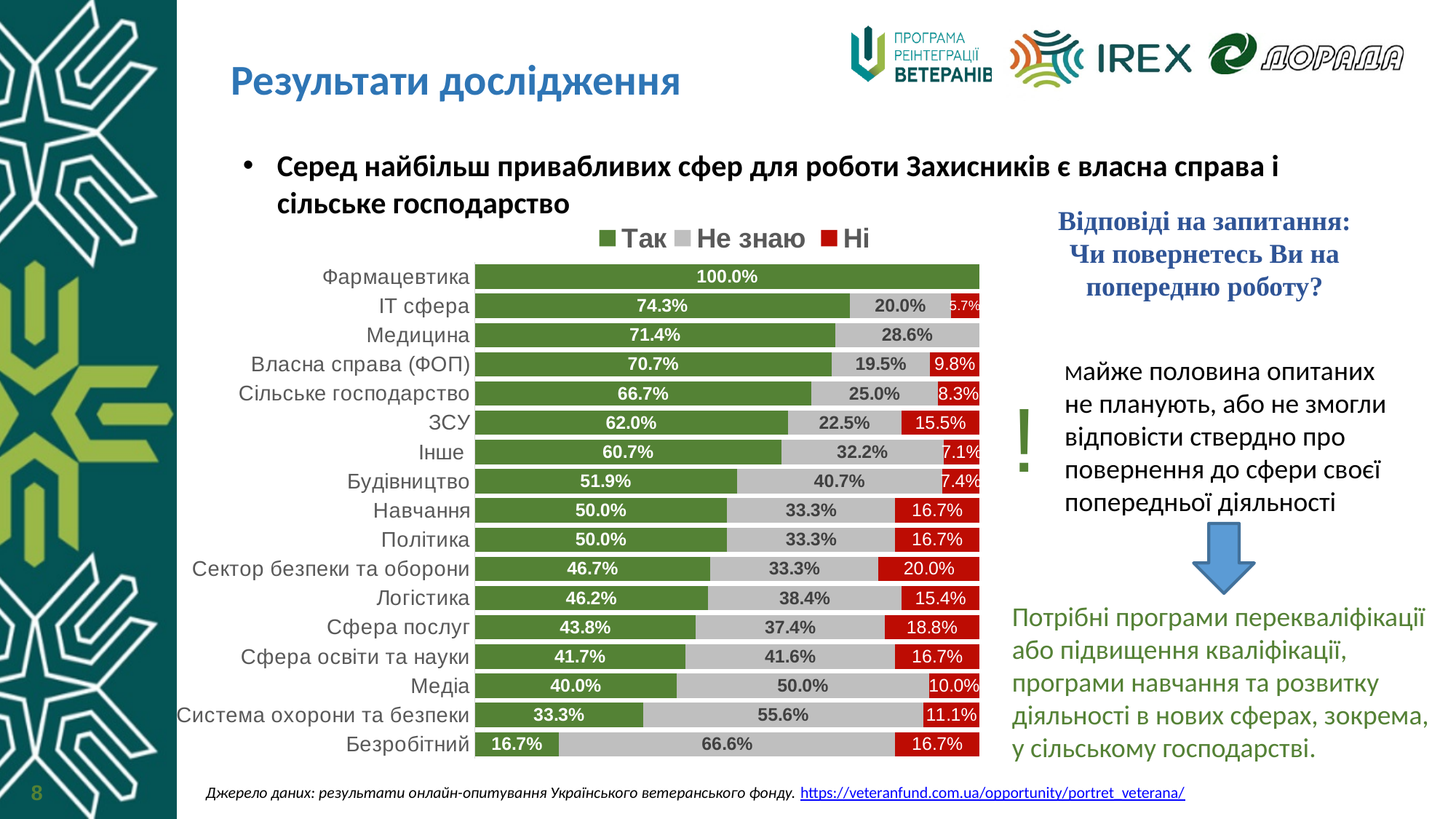
What is the 'Ні' value for Сектор безпеки та оборони? 20.0% How many series does the chart legend list? 3 What is the difference between the 'Так' values for Медицина and Медіа? 31.4% How many categories are shown on the chart? 17 What is the 'Так' value for Сільське господарство? 66.7% What is the 'Не знаю' value for Будівництво? 40.7% What is the 'Так' value for ІТ сфера? 74.3% Which has a larger 'Не знаю' value, Система охорони та безпеки or Логістика? Система охорони та безпеки Which category has the highest 'Так' value? Фармацевтика Which category has the lowest 'Так' value? Безробітний Which series is shown in red in the legend? Ні What type of chart is shown on the slide? Stacked bar chart